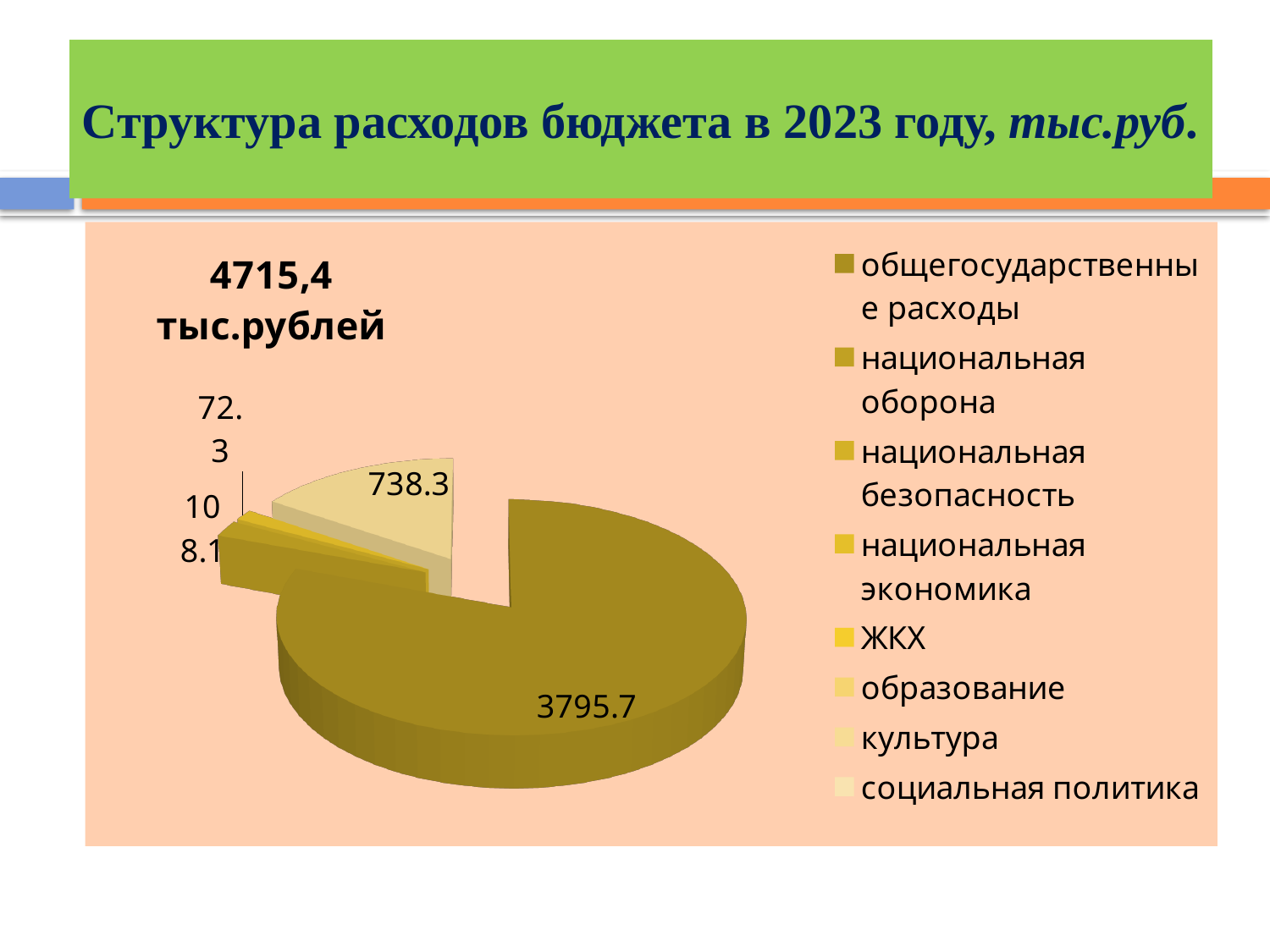
How many categories does the legend of the pie chart list? 8 What value is labelled on the largest slice of the pie chart? 3795.7 What value is labelled on the second-largest slice of the pie chart? 738.3 What kind of chart is shown on the slide? pie chart What is the difference between the largest slice (3795.7) and the second-largest slice (738.3)? 3057.4 Is the value of the largest slice greater or less than 3000? greater What is the title shown above the pie chart? 4715,4 тыс.рублей Which category has the largest slice in the pie chart? общегосударственные расходы What is the last category listed in the legend of the pie chart? социальная политика Which is larger: the slice labelled 3795.7 or the slice labelled 738.3? 3795.7